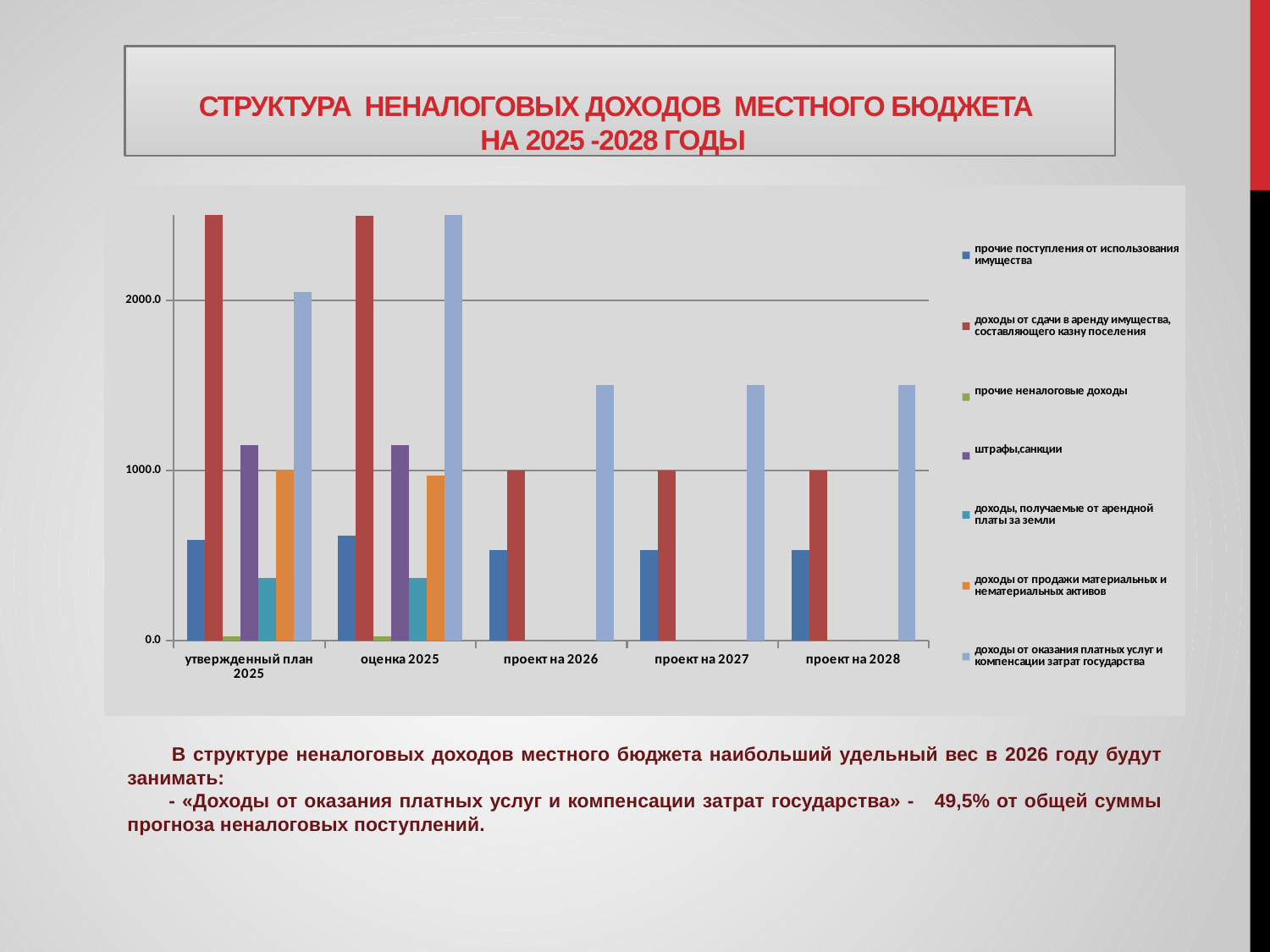
How many categories are shown along the x axis of the chart? 5 Which series has the lowest value in the 'оценка 2025' group? прочие неналоговые доходы What is the title of the slide containing the chart? СТРУКТУРА НЕНАЛОГОВЫХ ДОХОДОВ МЕСТНОГО БЮДЖЕТА НА 2025 -2028 ГОДЫ Does the value for 'доходы от оказания платных услуг и компенсации затрат государства' rise or fall from 'оценка 2025' to 'проект на 2026'? fall In the 'утвержденный план 2025' group, which is larger: 'доходы от сдачи в аренду имущества, составляющего казну поселения' or 'доходы от оказания платных услуг и компенсации затрат государства'? доходы от сдачи в аренду имущества, составляющего казну поселения Is the value for 'прочие поступления от использования имущества' in 'проект на 2028' greater or less than 1000.0? less Is the value for 'доходы от оказания платных услуг и компенсации затрат государства' in 'проект на 2027' greater or less than 1000.0? greater Is the value for 'штрафы,санкции' in 'утвержденный план 2025' greater or less than 1000.0? greater How many series does the chart legend list? 7 Which series has the highest value in the 'утвержденный план 2025' group? доходы от сдачи в аренду имущества, составляющего казну поселения Which series has the highest value in the 'проект на 2026' group? доходы от оказания платных услуг и компенсации затрат государства What kind of chart is shown on the slide? bar chart